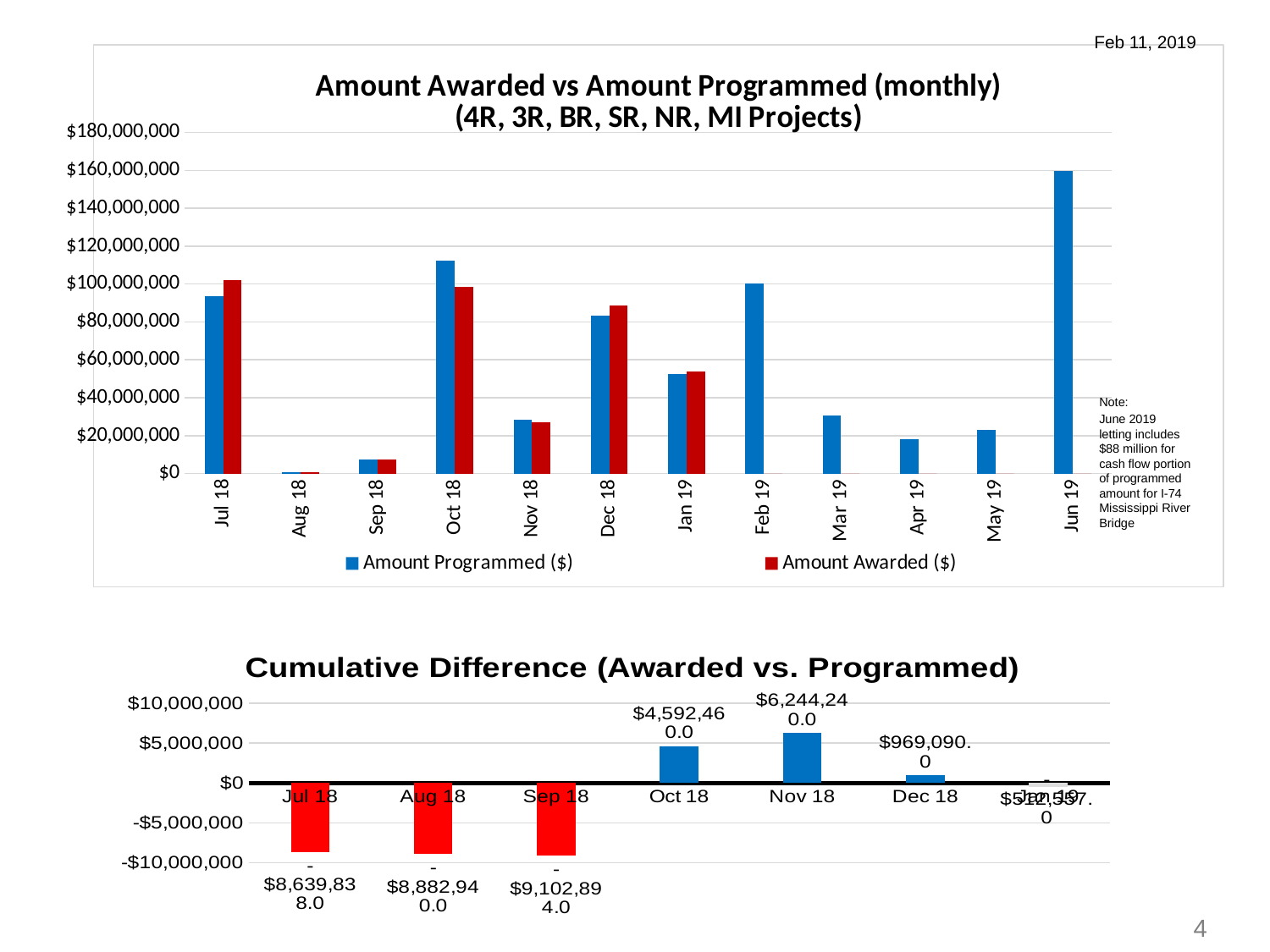
In the top chart, 'Amount Awarded vs Amount Programmed (monthly)', which month has the highest Amount Programmed ($)? Jun 19 What kind of chart is the top chart, 'Amount Awarded vs Amount Programmed (monthly)'? bar chart In the top chart, 'Amount Awarded vs Amount Programmed (monthly)', how many months are shown on the x axis? 12 In the top chart, 'Amount Awarded vs Amount Programmed (monthly)', which is larger for Oct 18: Amount Programmed ($) or Amount Awarded ($)? Amount Programmed ($) In the top chart, 'Amount Awarded vs Amount Programmed (monthly)', how many series does the legend list? 2 In the top chart, 'Amount Awarded vs Amount Programmed (monthly)', is the Amount Programmed ($) for Feb 19 greater or less than $80,000,000? greater In the top chart, 'Amount Awarded vs Amount Programmed (monthly)', is the Amount Programmed ($) for Jun 19 greater or less than $140,000,000? greater In the bottom chart, 'Cumulative Difference (Awarded vs. Programmed)', which month has the lowest value? Sep 18 In the bottom chart, 'Cumulative Difference (Awarded vs. Programmed)', what is the value for Sep 18? -$9,102,894.0 In the bottom chart, 'Cumulative Difference (Awarded vs. Programmed)', what is the value for Nov 18? $6,244,240.0 In the bottom chart, 'Cumulative Difference (Awarded vs. Programmed)', how much larger is the value for Nov 18 than the value for Oct 18? $1,651,780.0 In the bottom chart, 'Cumulative Difference (Awarded vs. Programmed)', how many months are plotted? 7